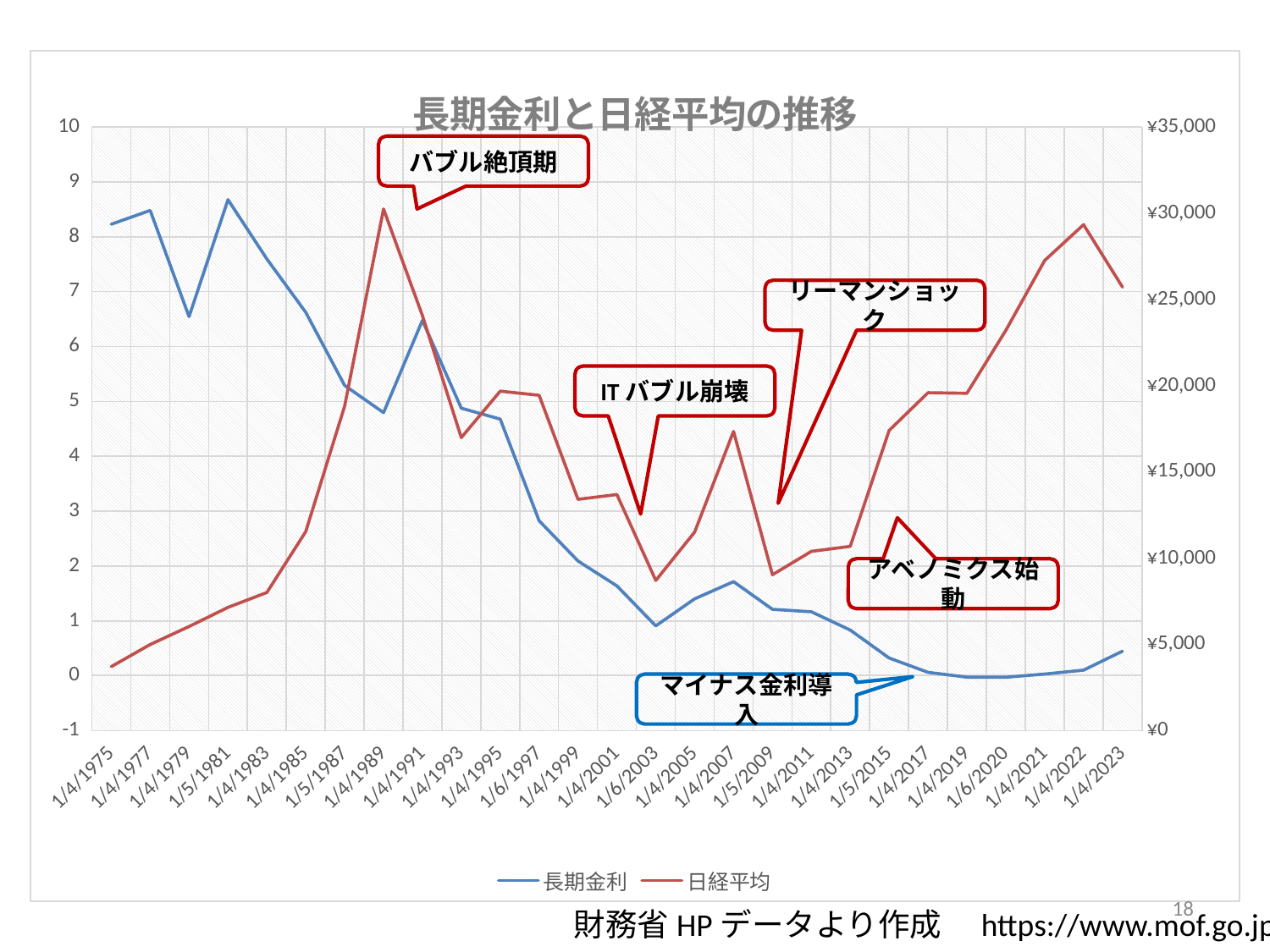
Which series is drawn in red? 日経平均 Does 長期金利 rise or fall from 1/4/1991 to 1/6/2003? fall How many dates are labelled on the x axis? 27 At which date is 日経平均 lowest? 1/4/1975 Which is larger, 長期金利 at 1/4/1991 or at 1/4/1995? 1/4/1991 Is the value of 日経平均 at 1/4/1989 greater or less than ¥25,000? greater Is the value of 日経平均 at 1/4/1975 greater or less than ¥5,000? less How many series does the legend list? 2 Is the value of 長期金利 at 1/5/1981 greater or less than 8? greater What kind of chart is shown on the slide? line chart What is the title of the chart? 長期金利と日経平均の推移